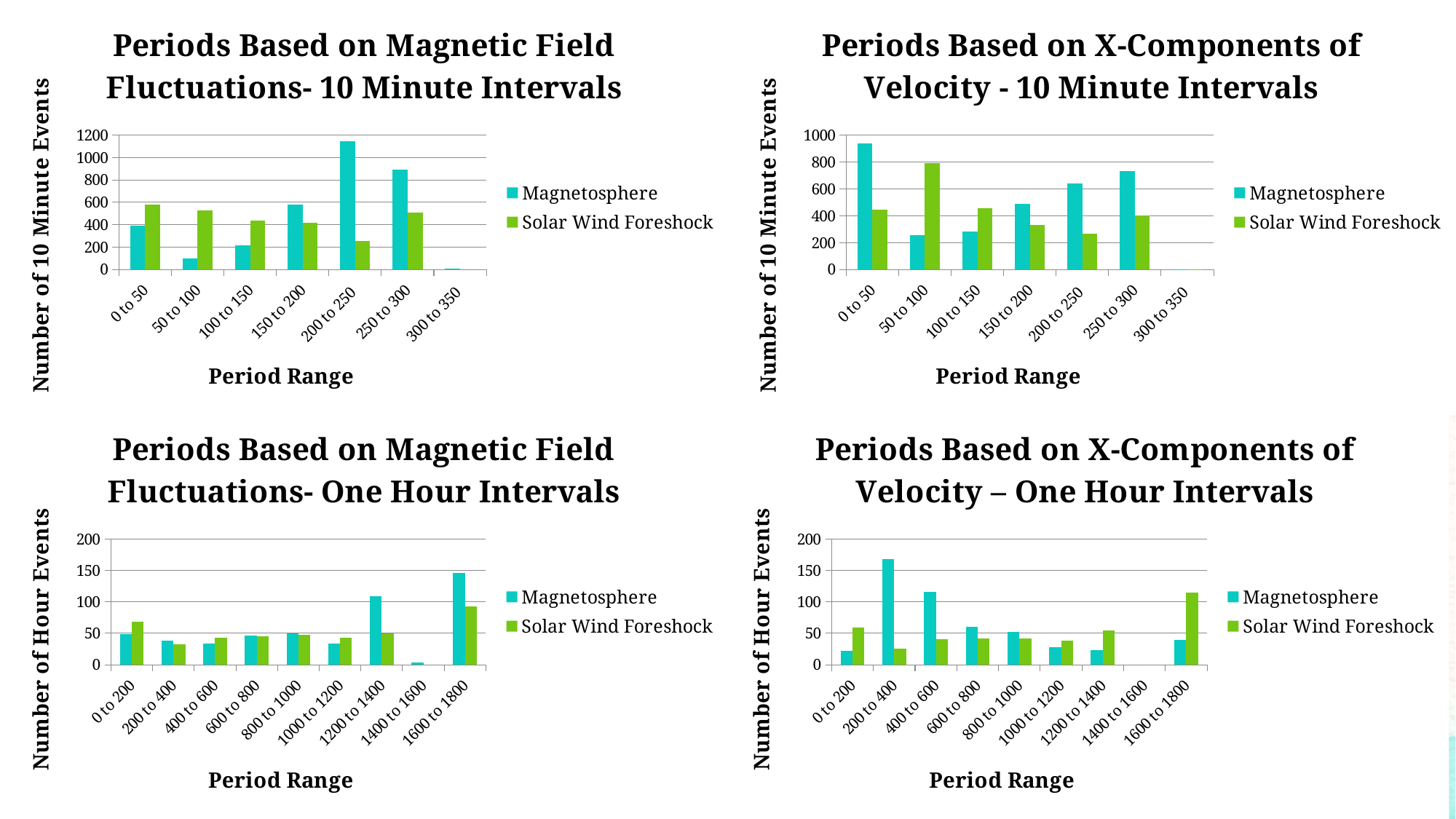
In the 'Periods Based on X-Components of Velocity - 10 Minute Intervals' chart, which period range has the highest Magnetosphere value? 0 to 50 In the 'Periods Based on X-Components of Velocity – One Hour Intervals' chart, is the Magnetosphere value for 200 to 400 greater or less than 150? greater In the 'Periods Based on X-Components of Velocity - 10 Minute Intervals' chart, which period range has the highest Solar Wind Foreshock value? 50 to 100 In the 'Periods Based on X-Components of Velocity - 10 Minute Intervals' chart, for the 50 to 100 range, which series is larger: Magnetosphere or Solar Wind Foreshock? Solar Wind Foreshock How many series does the legend of the 'Periods Based on X-Components of Velocity – One Hour Intervals' chart list? 2 In the 'Periods Based on Magnetic Field Fluctuations- One Hour Intervals' chart, which period range has the highest Magnetosphere value? 1600 to 1800 In the 'Periods Based on Magnetic Field Fluctuations- One Hour Intervals' chart, is the Magnetosphere value for 1200 to 1400 greater or less than 100? greater How many period ranges are shown on the x axis of the 'Periods Based on Magnetic Field Fluctuations- One Hour Intervals' chart? 9 In the 'Periods Based on Magnetic Field Fluctuations- 10 Minute Intervals' chart, is the Magnetosphere value for 200 to 250 greater or less than 1000? greater